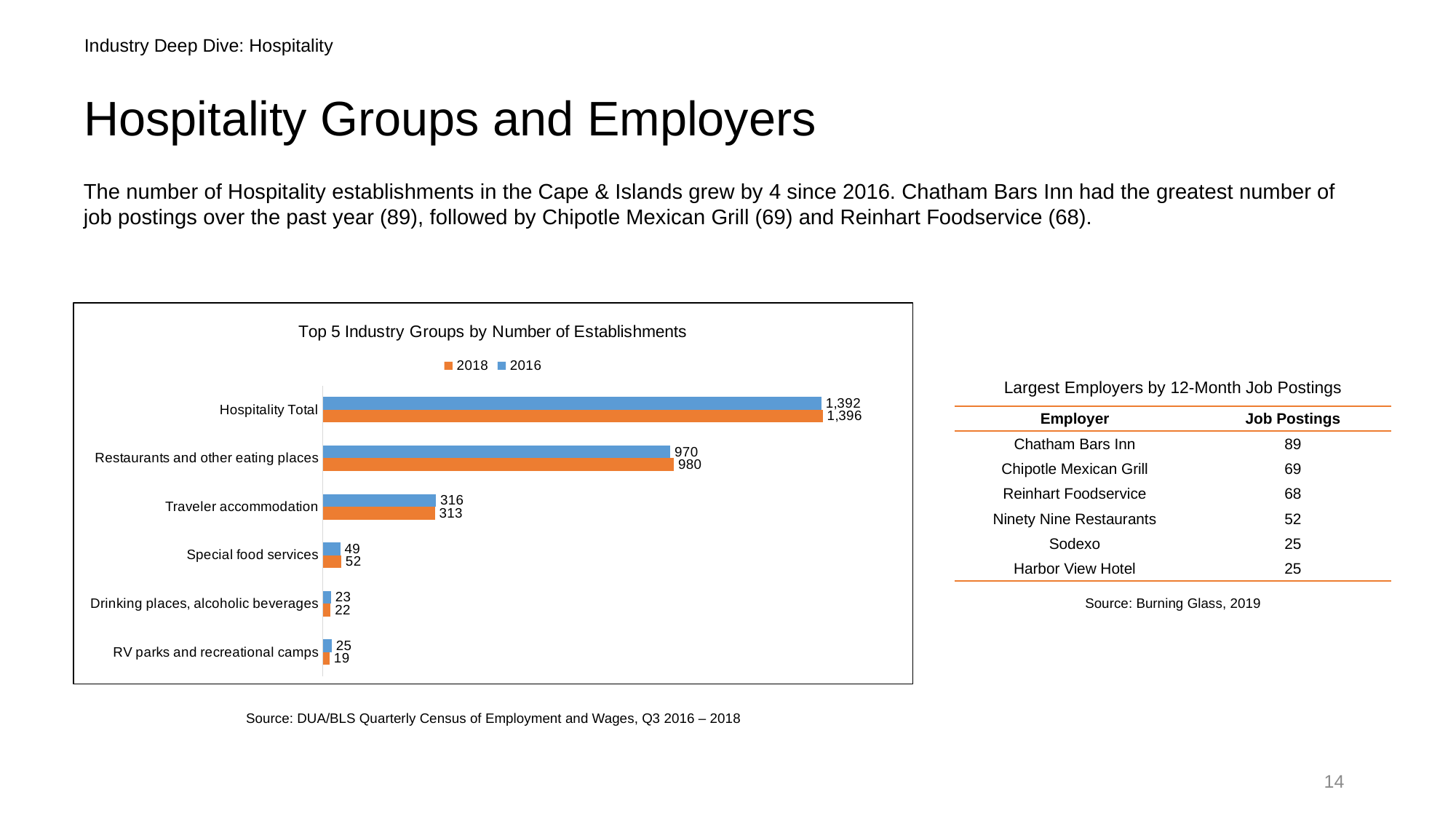
What is the 2018 value for Hospitality Total? 1,396 For Special food services, which year has the larger value, 2018 or 2016? 2018 What is the difference between the 2016 and 2018 values for RV parks and recreational camps? 6 What is the 2016 value for RV parks and recreational camps? 25 What is the 2016 value for Restaurants and other eating places? 970 What kind of chart is shown on the slide? Bar chart What is the difference between the 2018 and 2016 values for Hospitality Total? 4 How many categories are shown on the chart? 6 Excluding Hospitality Total, which category has the highest 2018 value? Restaurants and other eating places What is the 2018 value for Traveler accommodation? 313 Which category has the lowest 2018 value? RV parks and recreational camps How many series does the legend list? 2